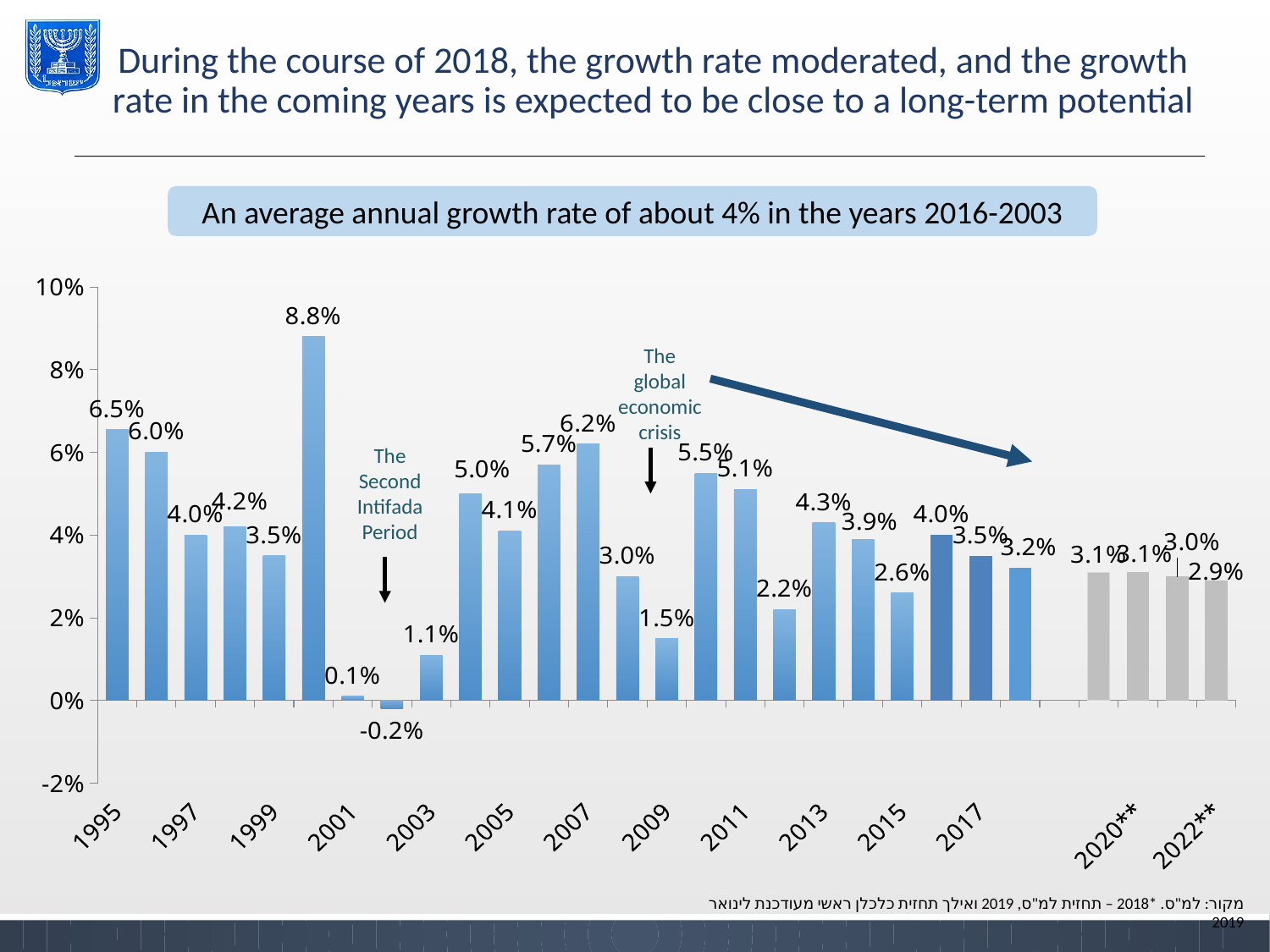
What is the difference between the growth rate for 1995 and the growth rate for 1997? 2.5 percentage points What is the growth rate shown for 2013? 4.3% What is the growth rate shown for 1995? 6.5% Do the growth rates generally rise or fall from 2010 to 2022? fall What is the growth rate shown for 2009? 1.5% What kind of chart is shown on the slide? bar chart Is the growth rate for 2011 greater or less than 4%? greater What is the growth rate shown for 2007? 6.2% What is the lowest growth rate value labelled on the chart? -0.2% What is the highest growth rate value labelled on the chart? 8.8% Which year has the higher growth rate, 2007 or 2009? 2007 What event does the annotation above the 2001-2002 bars refer to? The Second Intifada Period